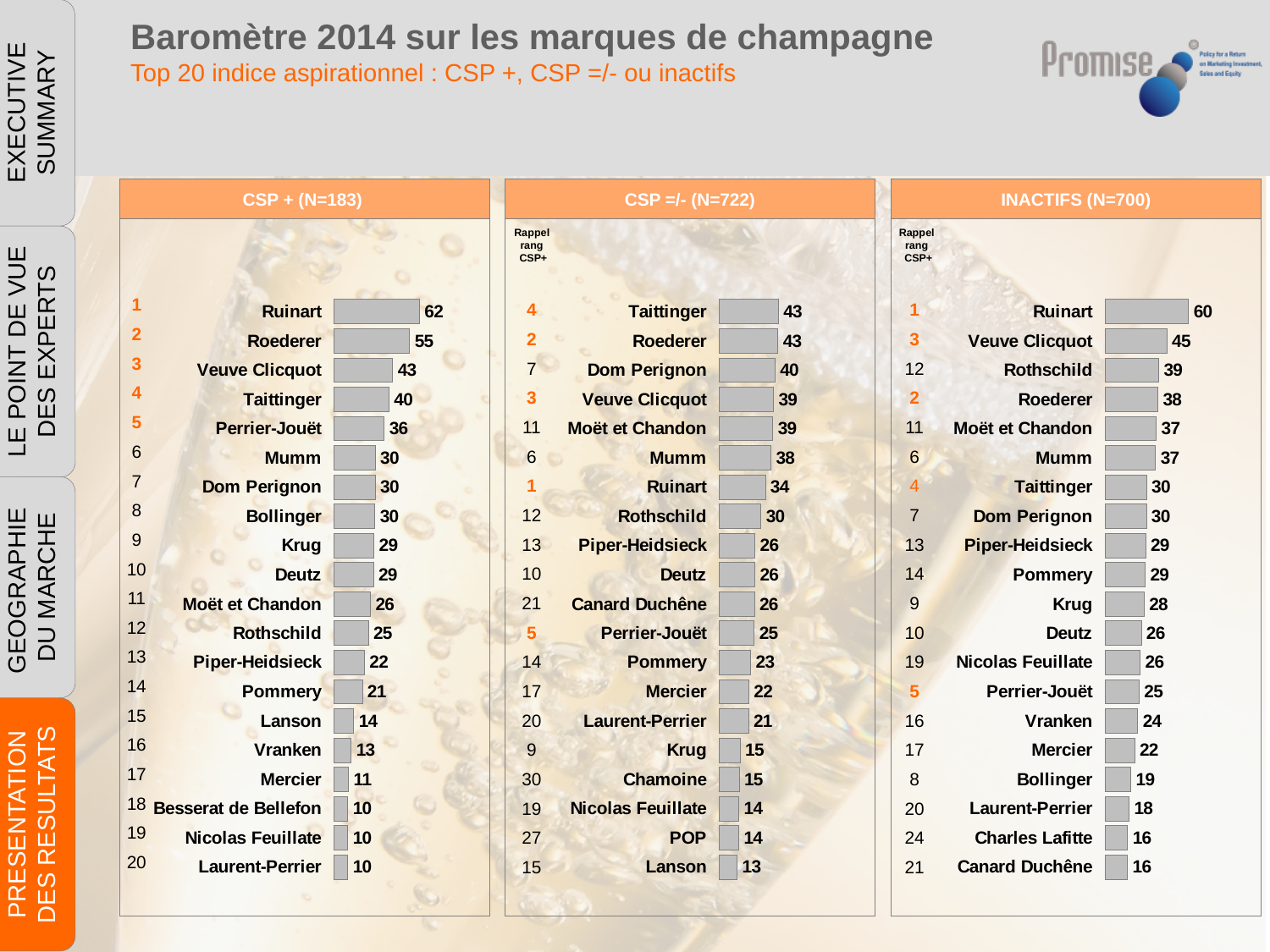
In the CSP + (N=183) chart, what is the difference between the values for Ruinart and Roederer? 7 In the CSP + (N=183) chart, which brand has the lowest value? Besserat de Bellefon, Nicolas Feuillate and Laurent-Perrier (tied at 10) How many brands are shown in the INACTIFS (N=700) chart? 20 In the CSP =/- (N=722) chart, which is larger, the value for Mumm or the value for Ruinart? Mumm What kind of chart is the CSP =/- (N=722) chart? Bar chart In the CSP =/- (N=722) chart, what is the value for Chamoine? 15 In the INACTIFS (N=700) chart, what is the difference between the values for Ruinart and Canard Duchêne? 44 In the INACTIFS (N=700) chart, which brand has the highest value? Ruinart In the CSP + (N=183) chart, what is the value for Ruinart? 62 How many charts are shown on the slide? 3 In the CSP =/- (N=722) chart, what is the value for Dom Perignon? 40 In the INACTIFS (N=700) chart, what is the value for Veuve Clicquot? 45